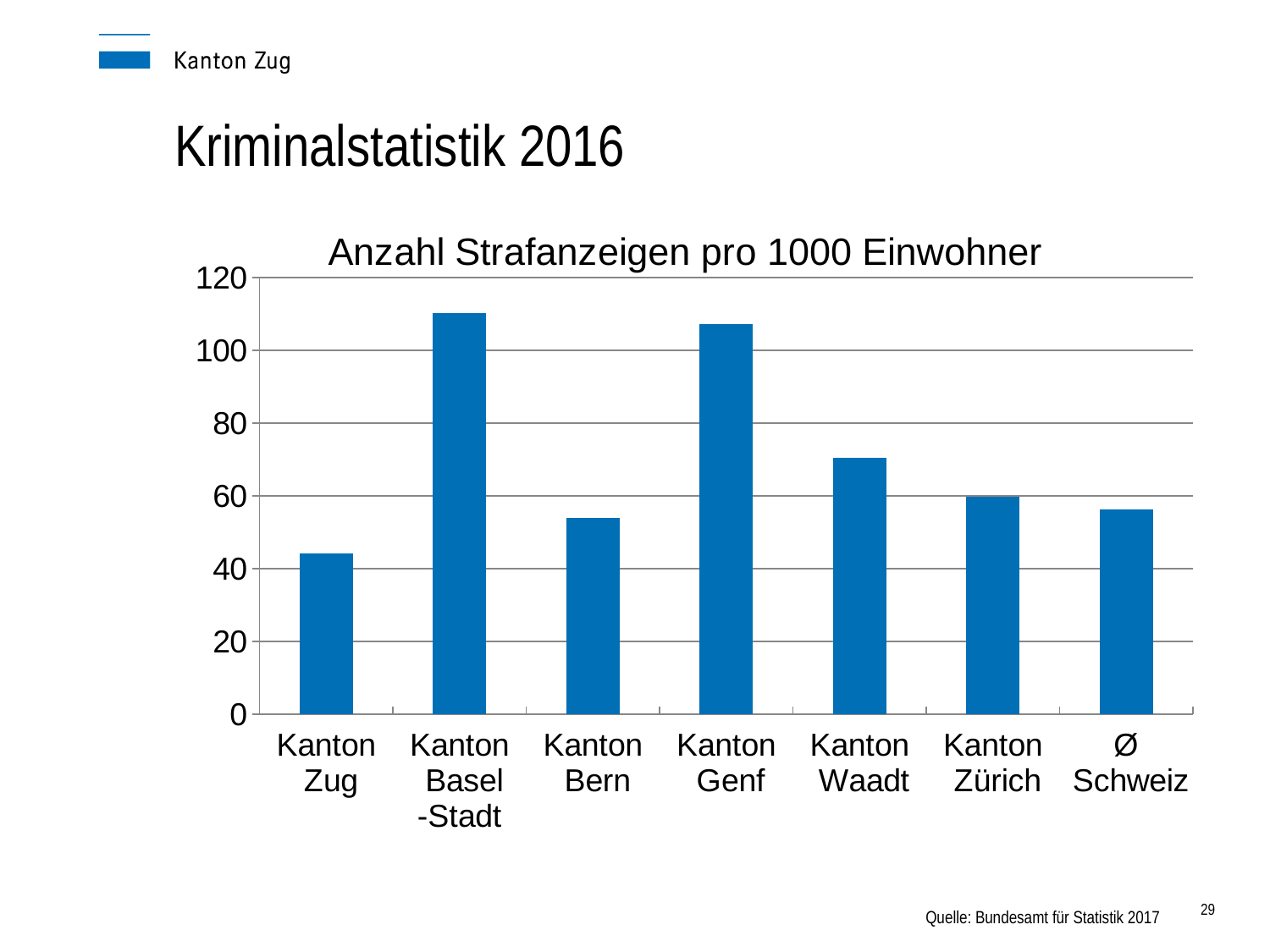
Is the value for Kanton Zug greater or less than 60? less What is the title of the chart? Anzahl Strafanzeigen pro 1000 Einwohner Is the value for Kanton Bern greater or less than 60? less Is the value for Kanton Genf greater or less than 100? greater What kind of chart is shown on the slide? bar chart Which is larger, the value for Kanton Basel-Stadt or the value for Kanton Bern? Kanton Basel-Stadt How many categories are shown on the x axis of the chart? 7 Which category has the lowest value in the chart? Kanton Zug Which is larger, the value for Kanton Zug or the value for Kanton Waadt? Kanton Waadt